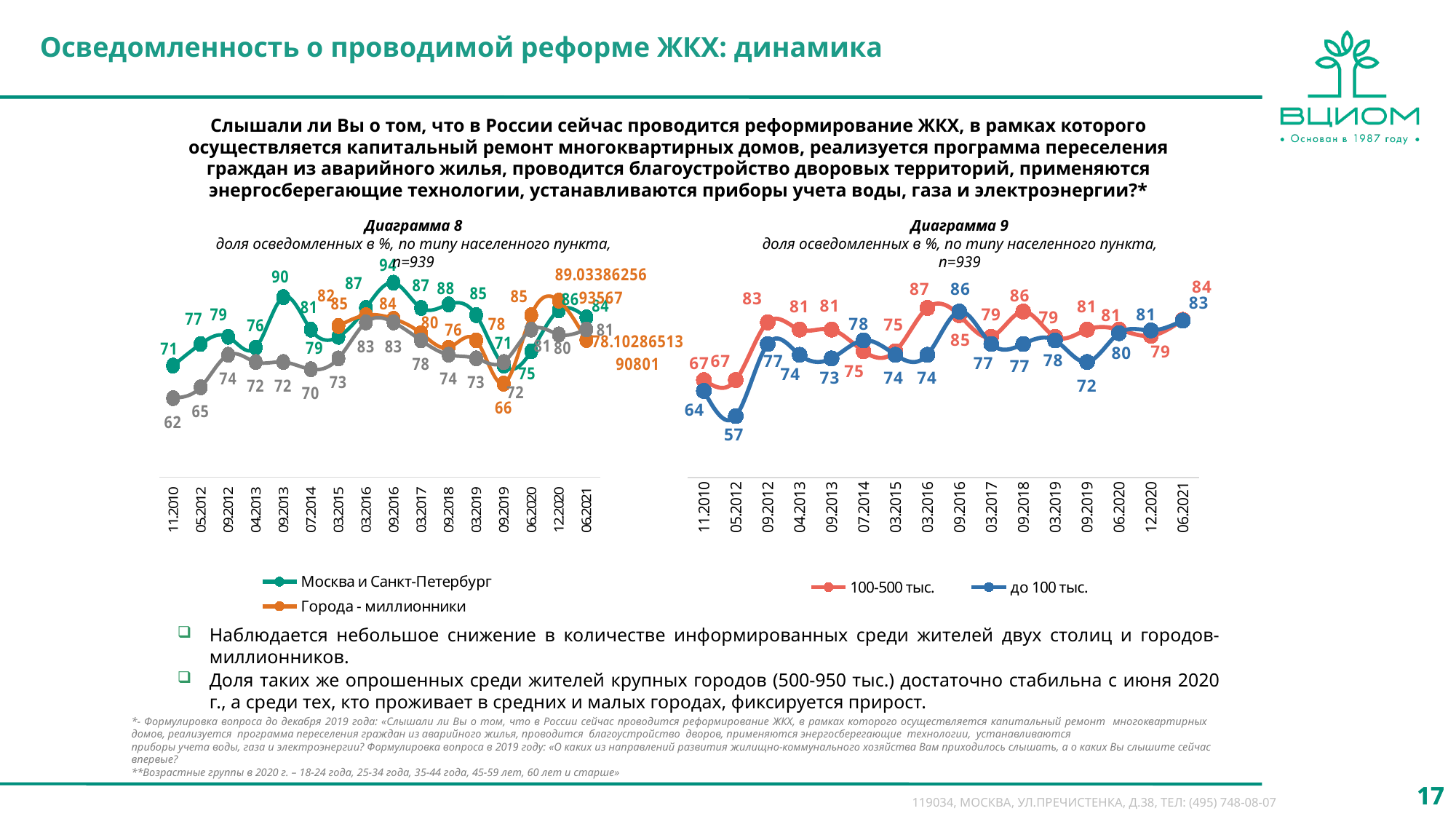
In Диаграмма 9, what is the value for '100-500 тыс.' at 06.2021? 84 In Диаграмма 9, what is the value for 'до 100 тыс.' at 05.2012? 57 How many dates are shown on the x axis of Диаграмма 8? 16 How many series does the legend of Диаграмма 9 list? 2 What kind of chart is Диаграмма 9? line chart In Диаграмма 9, at which date does the 'до 100 тыс.' series reach its lowest value? 05.2012 In Диаграмма 9, what is the difference between '100-500 тыс.' and 'до 100 тыс.' at 05.2012? 10 In Диаграмма 8, what is the value for 'Москва и Санкт-Петербург' at 09.2016? 94 In Диаграмма 9, at which date does the '100-500 тыс.' series reach its highest value? 03.2016 In Диаграмма 8, at which date does the 'Москва и Санкт-Петербург' series reach its highest value? 09.2016 In Диаграмма 9, which series has the higher value at 09.2018? 100-500 тыс. In Диаграмма 9, does the 'до 100 тыс.' series rise or fall from 09.2019 to 06.2021? rise